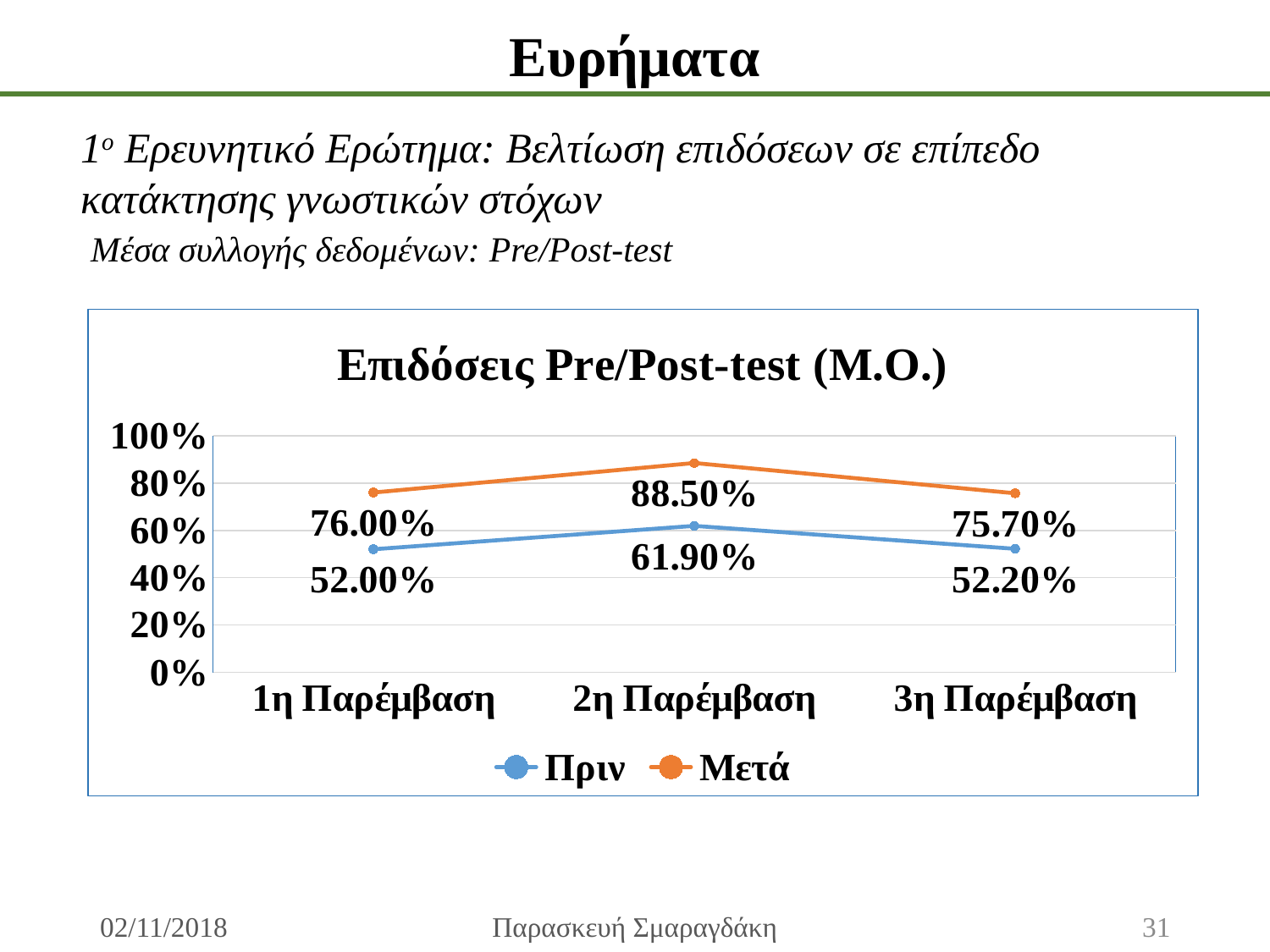
What is the value for Μετά at 3η Παρέμβαση? 75.70% What kind of chart is shown? line chart At which intervention is the Πριν value lowest? 1η Παρέμβαση Which is larger at 3η Παρέμβαση, the Πριν value or the Μετά value? Μετά What is the value for Πριν at 1η Παρέμβαση? 52.00% What is the value for Πριν at 2η Παρέμβαση? 61.90% How many interventions are shown on the x axis? 3 What is the value for Μετά at 1η Παρέμβαση? 76.00% What is the title of the chart? Επιδόσεις Pre/Post-test (Μ.Ο.) At which intervention is the Μετά value highest? 2η Παρέμβαση What is the difference between the Μετά and Πριν values at 2η Παρέμβαση? 26.60% How many series does the legend list? 2